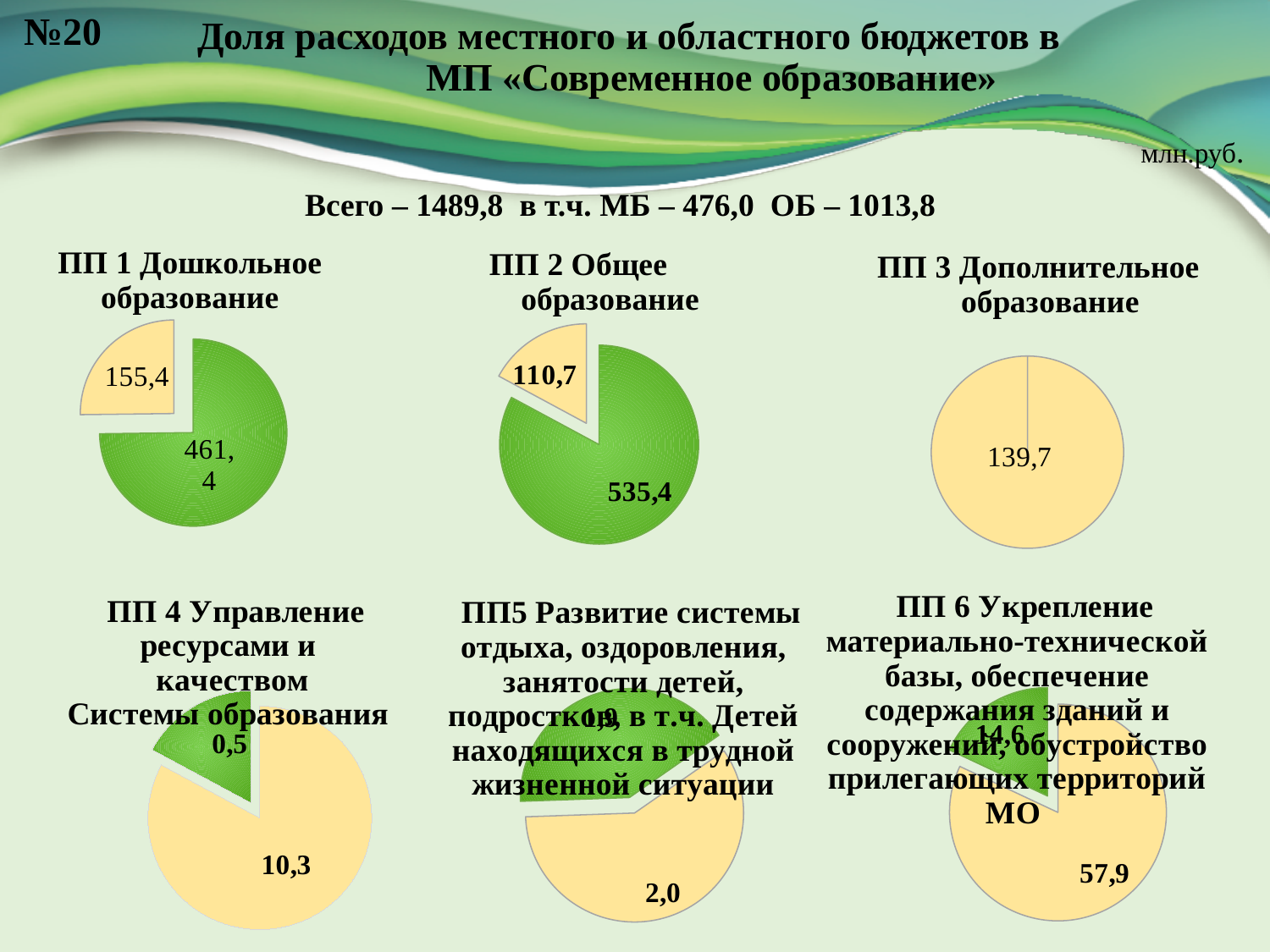
In the pie chart 'ПП 1 Дошкольное образование', what is the difference between the green slice and the yellow slice? 306,0 In the pie chart 'ПП 2 Общее образование', what is the difference between the green slice and the yellow slice? 424,7 In the pie chart 'ПП 6 Укрепление материально-технической базы...', what is the value of the larger (yellow) slice? 57,9 In the pie chart 'ПП 2 Общее образование', what is the value of the larger (green) slice? 535,4 In the pie chart 'ПП 4 Управление ресурсами и качеством Системы образования', what is the value of the larger (yellow) slice? 10,3 In the pie chart 'ПП 1 Дошкольное образование', what is the value of the larger (green) slice? 461,4 In the pie chart 'ПП 1 Дошкольное образование', what is the value of the smaller (yellow) slice? 155,4 In the pie chart 'ПП 4 Управление ресурсами и качеством Системы образования', what is the value of the smaller (green) slice? 0,5 How many pie charts are shown on the slide? 6 What value is shown in the pie chart 'ПП 3 Дополнительное образование'? 139,7 What type of charts are shown on the slide? Pie charts In the pie chart 'ПП 2 Общее образование', what is the value of the smaller (yellow) slice? 110,7